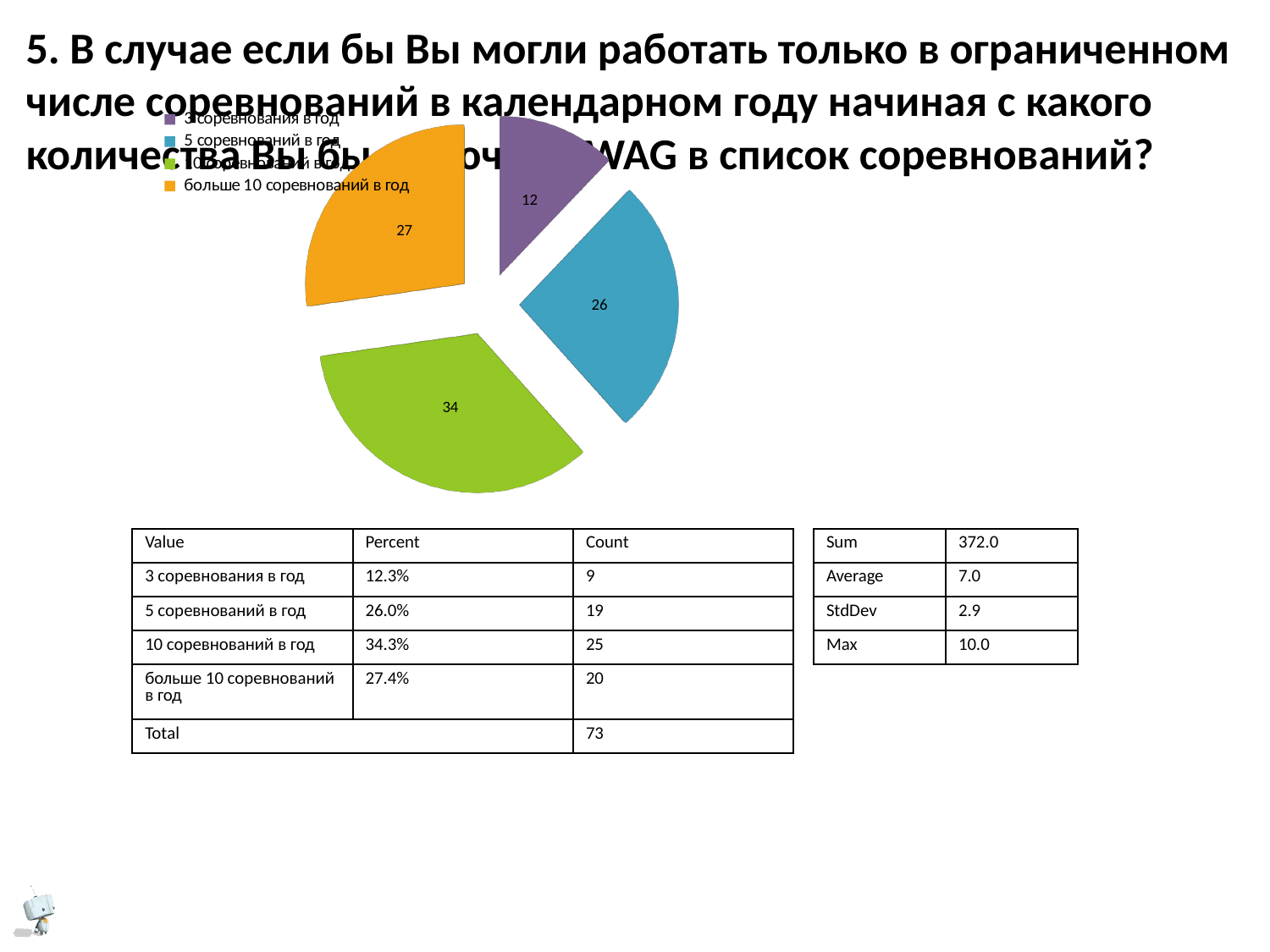
How many entries does the legend of the pie chart list? 4 How many slices does the pie chart have? 4 What is the data label on the orange slice of the pie chart (больше 10 соревнований в год)? 27 Which slice of the pie chart has the largest value? 10 соревнований в год What is the data label on the blue slice of the pie chart (5 соревнований в год)? 26 What is the difference between the data labels of the green slice (34) and the purple slice (12) in the pie chart? 22 Which slice of the pie chart has the smallest value? 3 соревнования в год What kind of chart is shown on the slide? pie chart What is the data label on the green slice of the pie chart (10 соревнований в год)? 34 Which slice is larger in the pie chart: the orange slice (больше 10 соревнований в год) or the blue slice (5 соревнований в год)? больше 10 соревнований в год What colour is the slice for 'больше 10 соревнований в год' in the pie chart? orange What is the data label on the purple slice of the pie chart (3 соревнования в год)? 12